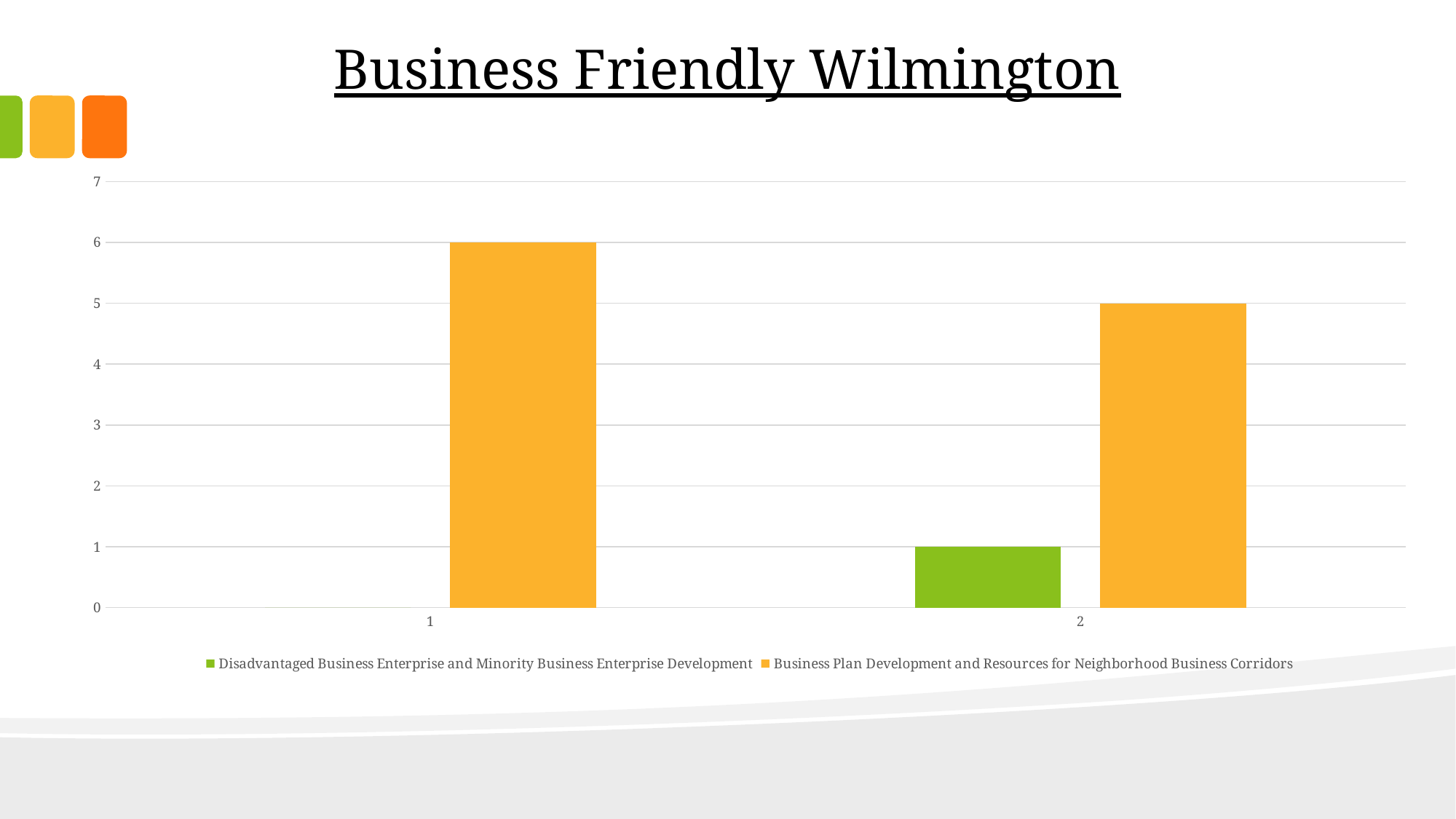
How many series does the legend list? 2 What is the difference between the Business Plan Development and Resources for Neighborhood Business Corridors values in category 1 and category 2? 1 In category 2, which series has the larger value? Business Plan Development and Resources for Neighborhood Business Corridors Which category has the higher value for Business Plan Development and Resources for Neighborhood Business Corridors? 1 What kind of chart is shown on the slide? bar chart What is the difference between the two series' values in category 2? 4 What is the value for Disadvantaged Business Enterprise and Minority Business Enterprise Development in category 2? 1 What is the value for Business Plan Development and Resources for Neighborhood Business Corridors in category 2? 5 What colour represents Disadvantaged Business Enterprise and Minority Business Enterprise Development in the legend? green How many categories are shown on the x axis? 2 What is the value for Business Plan Development and Resources for Neighborhood Business Corridors in category 1? 6 Does the value for Business Plan Development and Resources for Neighborhood Business Corridors rise or fall from category 1 to category 2? fall